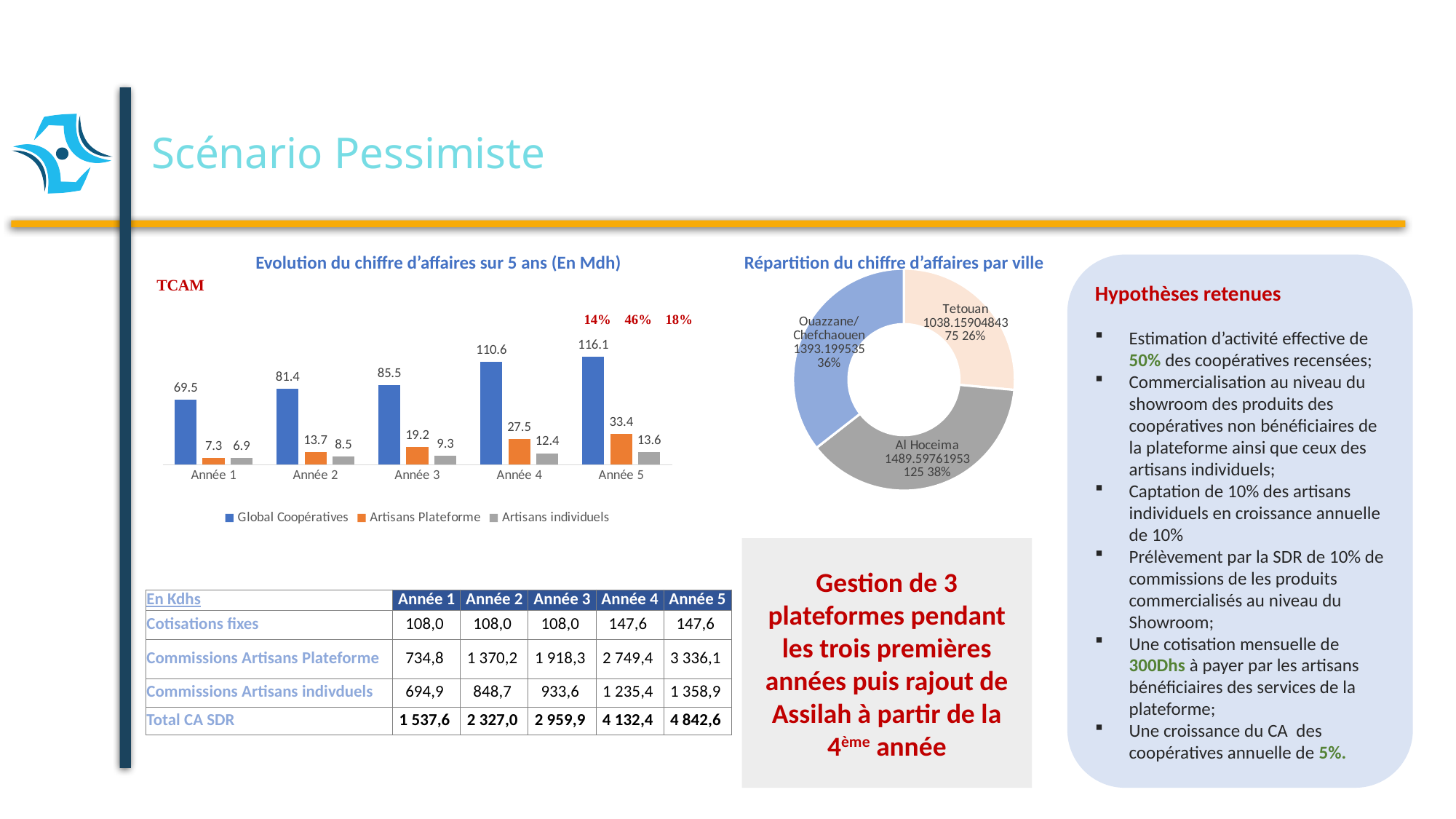
How many series does the legend of the chart 'Evolution du chiffre d'affaires sur 5 ans (En Mdh)' list? 3 In the chart 'Evolution du chiffre d'affaires sur 5 ans (En Mdh)', what is the difference between the Global Coopératives values in Année 4 and Année 3? 25.1 In the chart 'Répartition du chiffre d'affaires par ville', what share does Al Hoceima have? 38% In the chart 'Evolution du chiffre d'affaires sur 5 ans (En Mdh)', what is the value for Artisans Plateforme in Année 3? 19.2 In the chart 'Evolution du chiffre d'affaires sur 5 ans (En Mdh)', which year has the highest value for Global Coopératives? Année 5 In the chart 'Evolution du chiffre d'affaires sur 5 ans (En Mdh)', which is larger in Année 2: Artisans Plateforme or Artisans individuels? Artisans Plateforme In the chart 'Evolution du chiffre d'affaires sur 5 ans (En Mdh)', which year has the lowest value for Artisans Plateforme? Année 1 In the chart 'Evolution du chiffre d'affaires sur 5 ans (En Mdh)', what is the value for Global Coopératives in Année 5? 116.1 In the chart 'Répartition du chiffre d'affaires par ville', which city has the smallest share? Tetouan In the chart 'Evolution du chiffre d'affaires sur 5 ans (En Mdh)', do the Artisans individuels values rise or fall from Année 1 to Année 5? rise What kind of chart is 'Evolution du chiffre d'affaires sur 5 ans (En Mdh)'? bar chart In the chart 'Evolution du chiffre d'affaires sur 5 ans (En Mdh)', what is the value for Artisans individuels in Année 1? 6.9